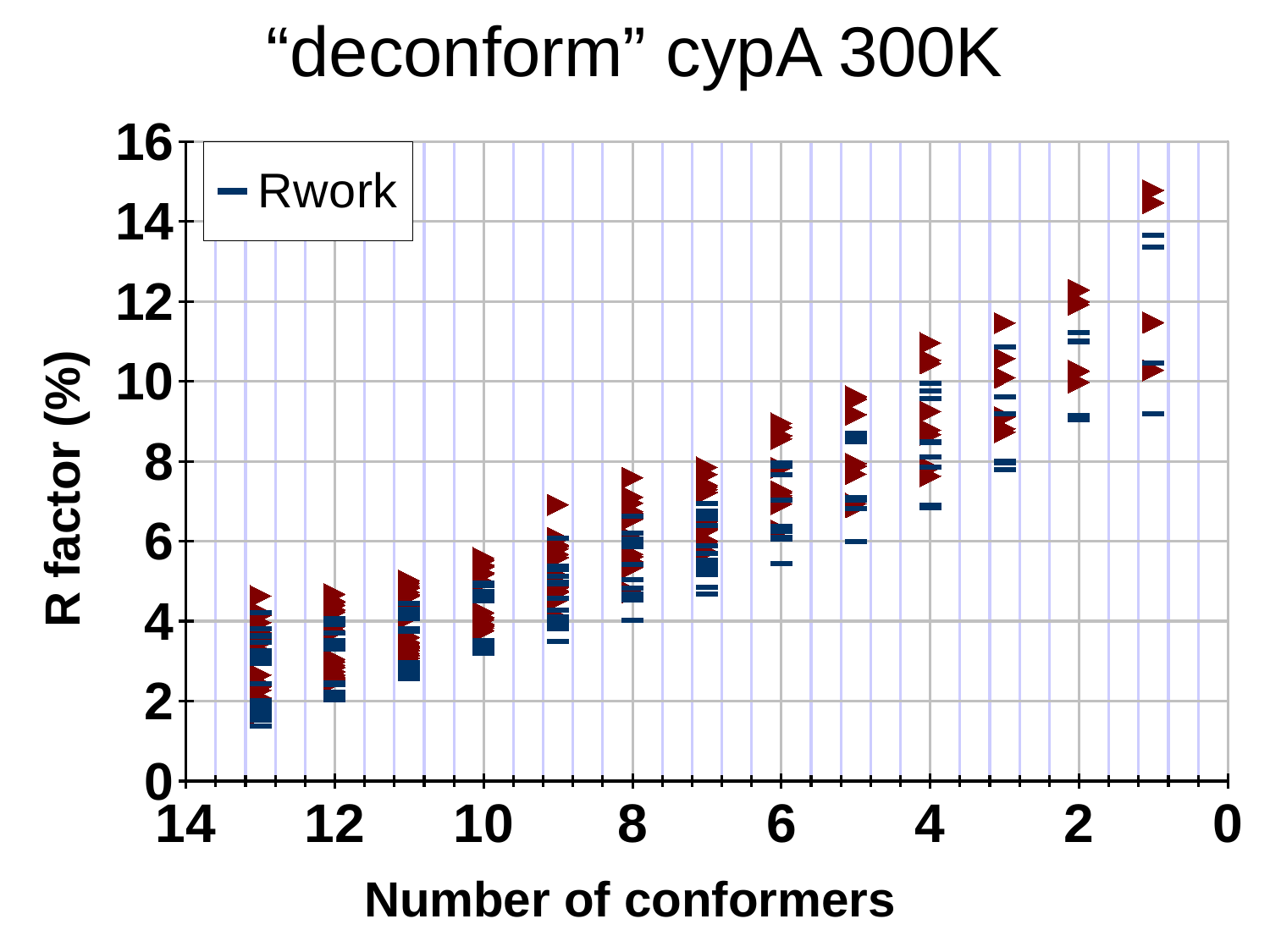
Are all the R factor values at 13 conformers greater or less than 6? less What is the highest value shown on the y axis? 16 How many series does the legend list? 1 Is the highest red triangle value at 6 conformers greater or less than 8? greater What is the label of the y axis? R factor (%) Do the R factor values rise or fall as the number of conformers decreases from 13 to 1? rise What kind of chart is shown on the slide? scatter plot Is the lowest Rwork value at 4 conformers greater or less than 8? less What is the title of the chart? "deconform" cypA 300K How many distinct numbers of conformers have data points plotted? 13 Which has higher red triangle values: 1 conformer or 13 conformers? 1 conformer